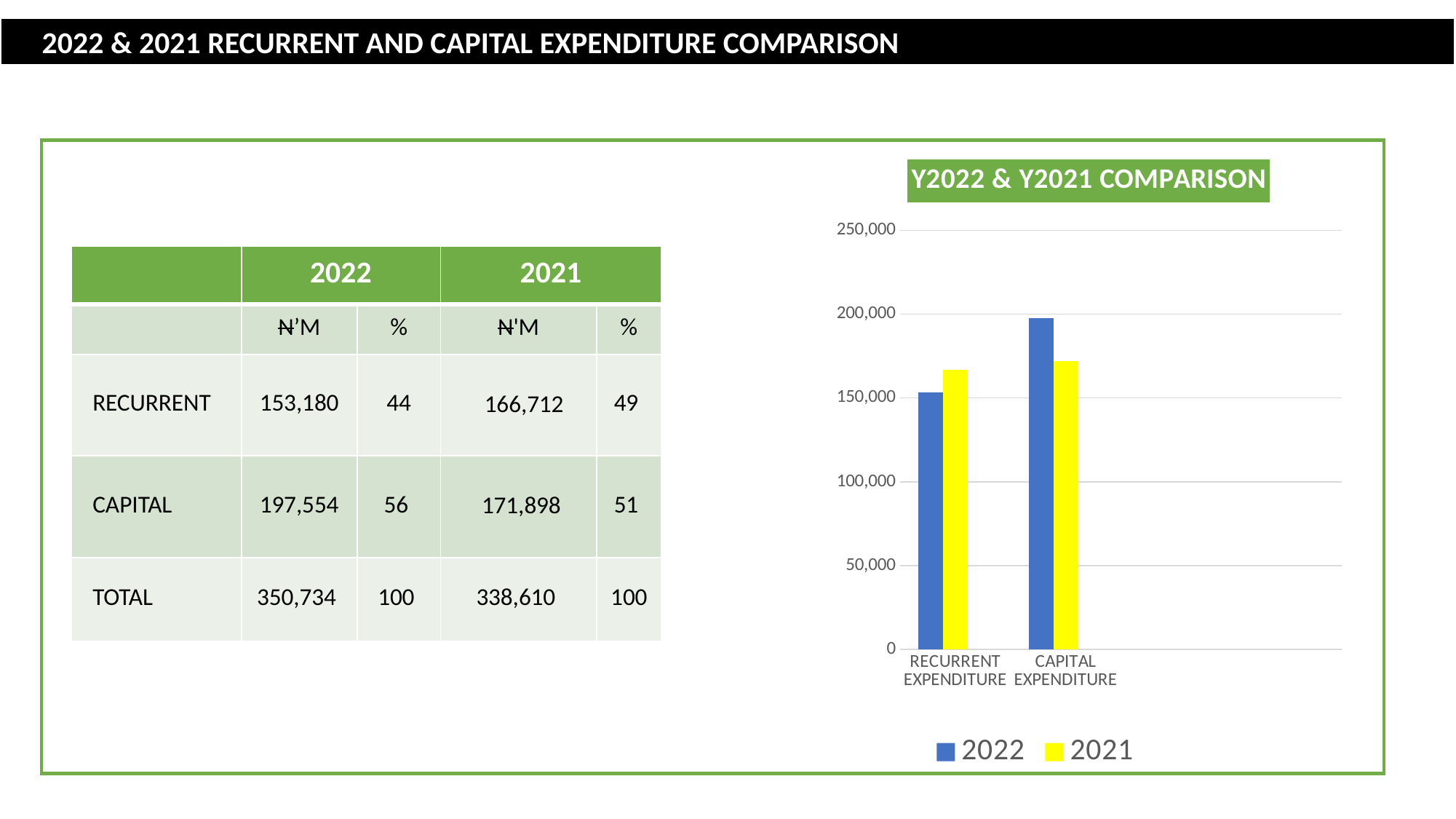
In the chart, is the 2022 bar for Capital Expenditure taller or shorter than the 2021 bar for Capital Expenditure? taller Is the 2021 value for Recurrent Expenditure greater or less than 150,000? greater In the chart, is the 2022 bar for Recurrent Expenditure taller or shorter than the 2021 bar for Recurrent Expenditure? shorter According to the slide, what is the 2022 Capital expenditure in N'M? 197,554 How many expenditure categories are shown on the x axis of the chart? 2 Which colour represents the 2021 series in the chart? yellow Which bar in the chart is the tallest? 2022 Capital Expenditure According to the slide, what is the 2021 Recurrent expenditure in N'M? 166,712 What kind of chart is shown under the title 'Y2022 & Y2021 COMPARISON'? bar chart Is the 2021 value for Capital Expenditure greater or less than 200,000? less Which bar in the chart is the shortest? 2022 Recurrent Expenditure How many series does the legend of the 'Y2022 & Y2021 COMPARISON' chart list? 2